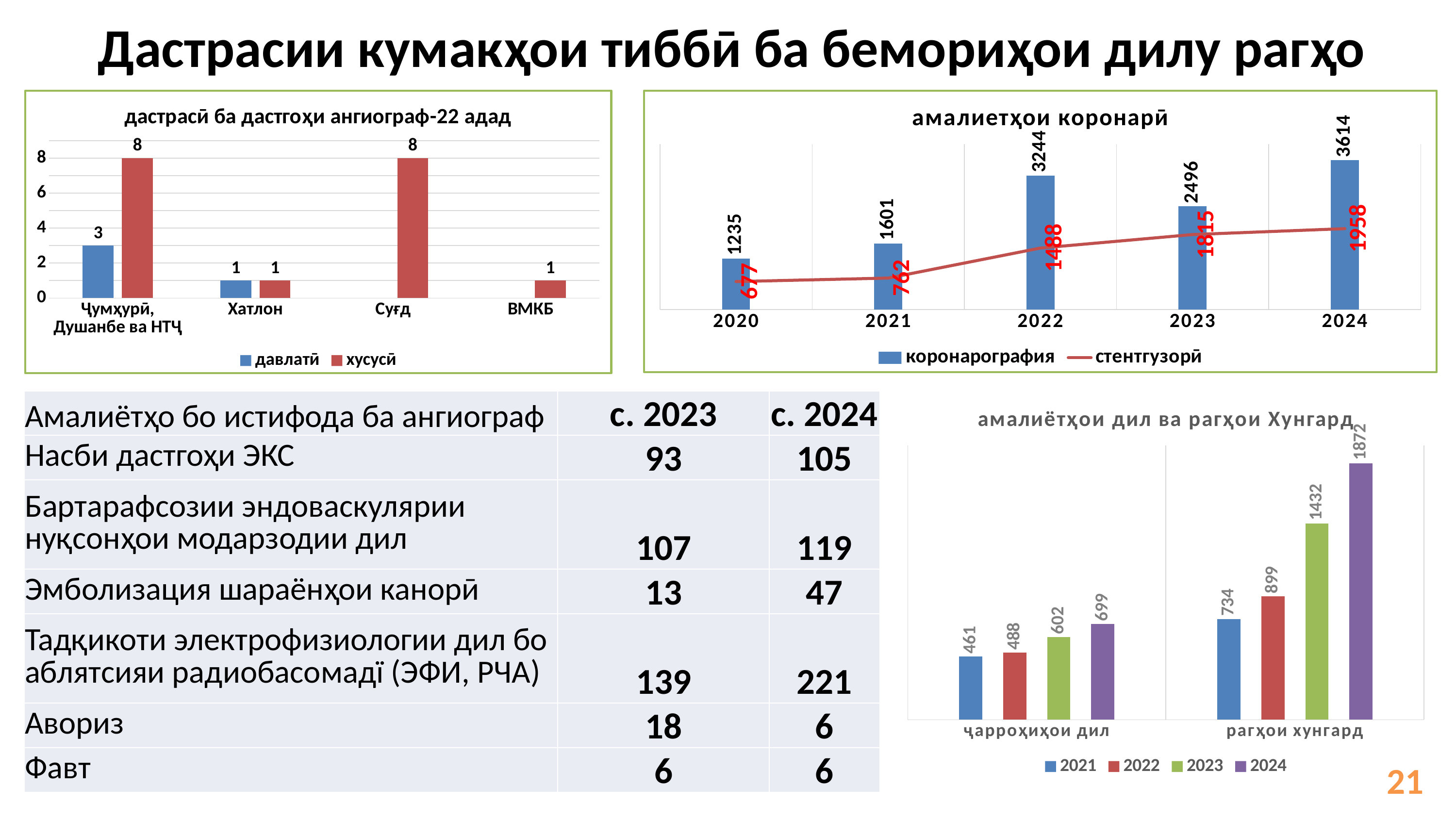
In the chart titled 'амалиётҳои дил ва рагҳои Хунгард', what is the difference between the 2024 and 2021 values for ҷарроҳиҳои дил? 238 In the chart titled 'амалиетҳои коронарӣ', which year has the highest коронарография value? 2024 In the chart titled 'дастрасӣ ба дастгоҳи ангиограф-22 адад', what is the value of давлатӣ for Ҷумҳурӣ, Душанбе ва НТҶ? 3 In the chart titled 'амалиетҳои коронарӣ', what is the value of коронарография for 2022? 3244 In the chart titled 'амалиетҳои коронарӣ', how many years are shown on the x axis? 5 In the chart titled 'амалиётҳои дил ва рагҳои Хунгард', what is the value for рагҳои хунгард in 2024? 1872 In the chart titled 'амалиётҳои дил ва рагҳои Хунгард', which is larger: рагҳои хунгард in 2022 or ҷарроҳиҳои дил in 2024? рагҳои хунгард in 2022 In the chart titled 'амалиетҳои коронарӣ', what is the value of стентгузорӣ for 2024? 1958 In the chart titled 'амалиетҳои коронарӣ', does стентгузорӣ rise or fall from 2020 to 2024? rise In the chart titled 'дастрасӣ ба дастгоҳи ангиограф-22 адад', what is the difference between хусусӣ and давлатӣ for Ҷумҳурӣ, Душанбе ва НТҶ? 5 In the chart titled 'дастрасӣ ба дастгоҳи ангиограф-22 адад', what is the value of хусусӣ for Суғд? 8 In the chart titled 'дастрасӣ ба дастгоҳи ангиограф-22 адад', how many series does the legend list? 2